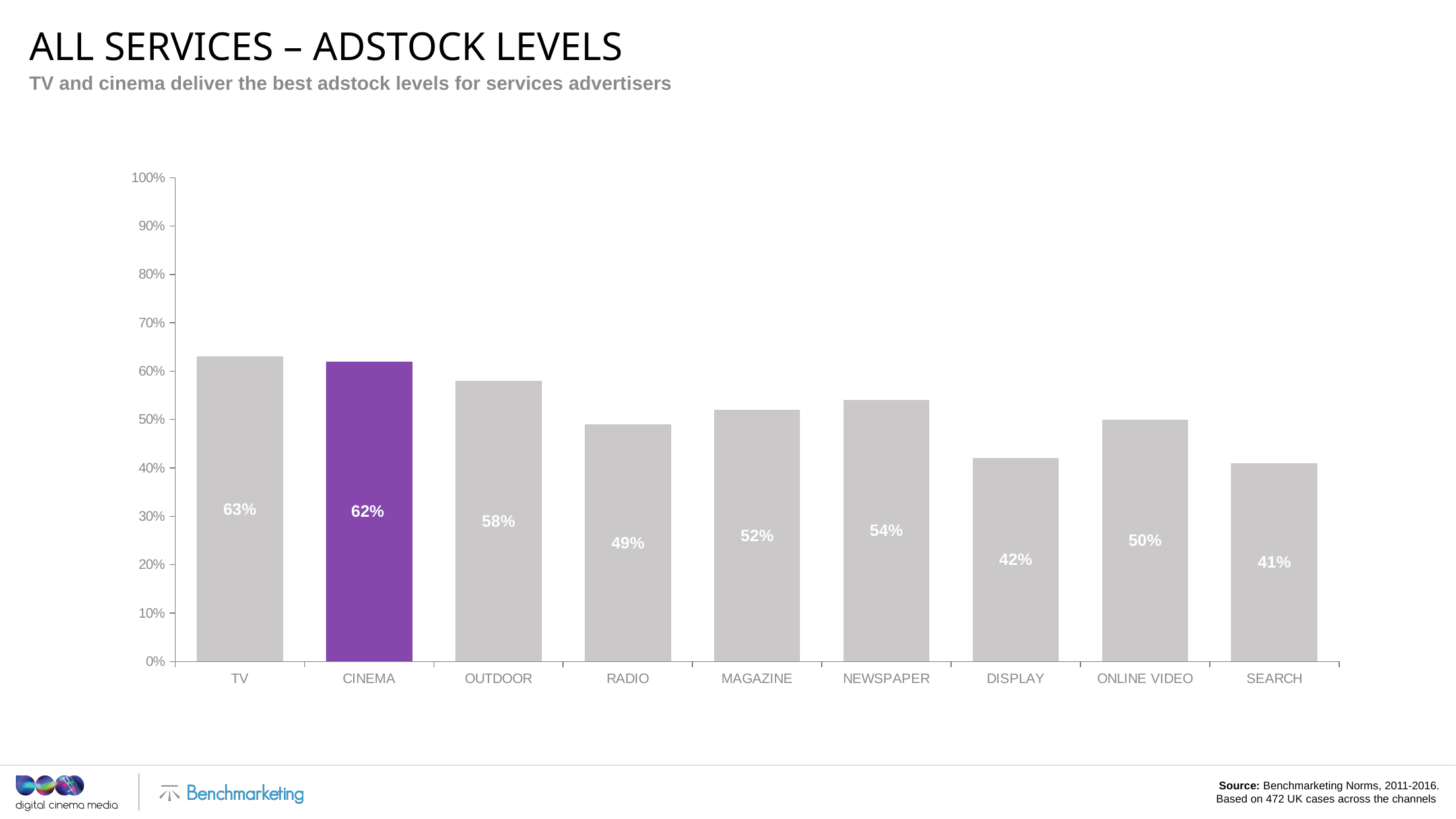
Is the value for DISPLAY greater or less than 50%? less Which channel has the lowest adstock level? SEARCH Which bar is highlighted in purple? CINEMA Which channel has the highest adstock level? TV What is the adstock level for NEWSPAPER? 54% What is the difference between the adstock levels for TV and SEARCH? 22% What is the adstock level for ONLINE VIDEO? 50% What kind of chart is shown on the slide? Bar chart What is the difference between the adstock levels for OUTDOOR and RADIO? 9% What is the adstock level for CINEMA? 62% Which has a higher adstock level, MAGAZINE or DISPLAY? MAGAZINE How many channels are shown on the chart? 9